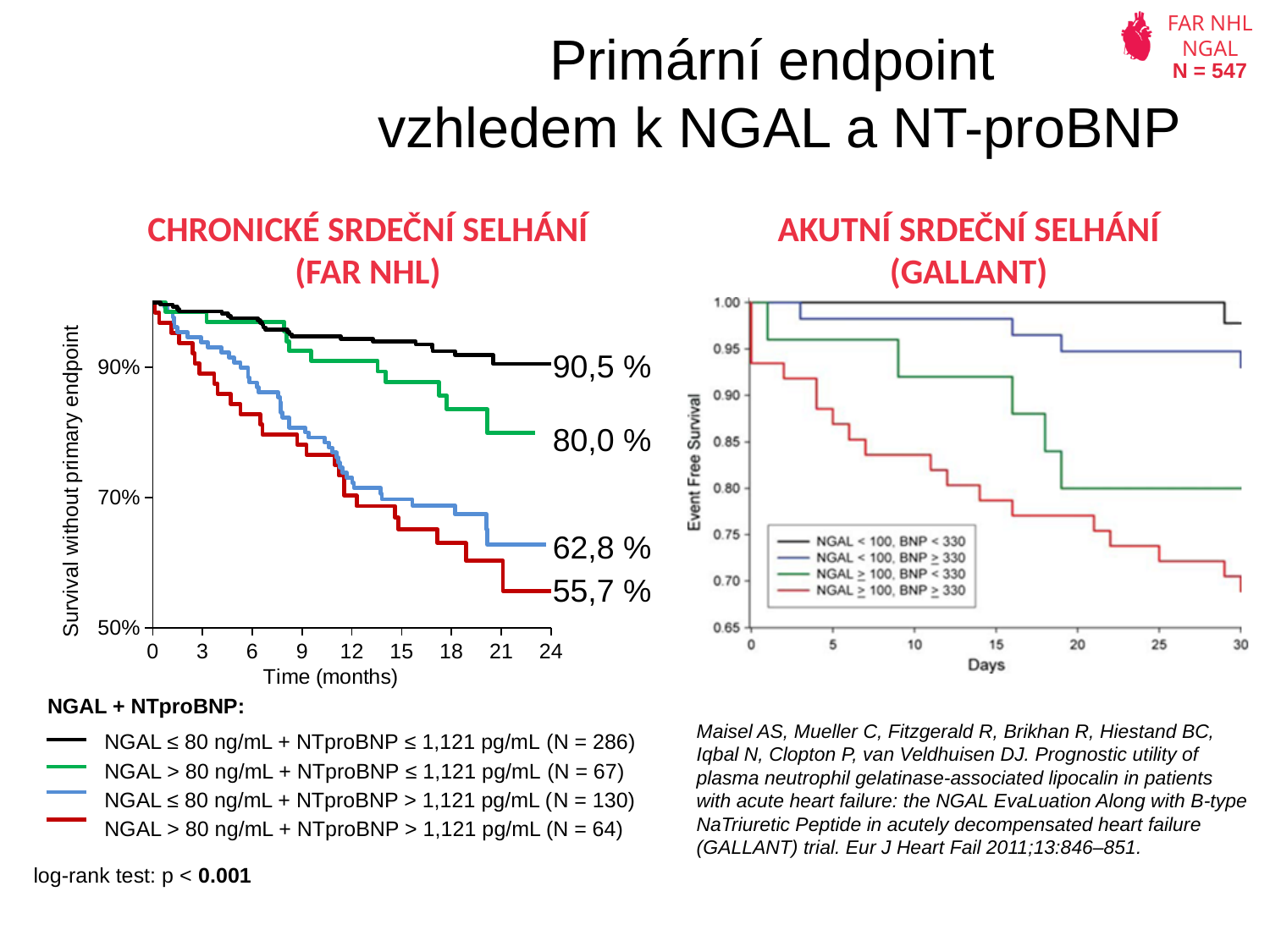
On the right chart (GALLANT), is the event-free survival of the NGAL < 100, BNP < 330 group at day 30 greater or less than 0.95? greater On the left chart (FAR NHL), do the survival curves rise or fall over time? fall What kind of chart is the left chart (FAR NHL)? line chart (Kaplan-Meier survival curves) On the right chart (GALLANT), which group has the lowest event-free survival at day 30? NGAL ≥ 100, BNP ≥ 330 On the left chart (FAR NHL), how many patients are in the group NGAL ≤ 80 ng/mL + NTproBNP > 1,121 pg/mL according to the legend? 130 On the right chart (AKUTNÍ SRDEČNÍ SELHÁNÍ, GALLANT), how many series does the legend list? 4 On the left chart (FAR NHL), what is the final survival value for the group NGAL > 80 ng/mL + NTproBNP > 1,121 pg/mL? 55,7 % On the left chart (FAR NHL), which group has the highest survival without primary endpoint at the end of follow-up? NGAL ≤ 80 ng/mL + NTproBNP ≤ 1,121 pg/mL On the left chart (CHRONICKÉ SRDEČNÍ SELHÁNÍ, FAR NHL), what is the survival without primary endpoint at the end of follow-up for the group NGAL ≤ 80 ng/mL + NTproBNP ≤ 1,121 pg/mL? 90,5 % On the left chart (FAR NHL), how many groups (series) does the legend list? 4 On the left chart (FAR NHL), what is the difference between the final survival values of the green group (80,0 %) and the blue group (62,8 %)? 17,2 % On the left chart (FAR NHL), which group has the lowest survival without primary endpoint at the end of follow-up? NGAL > 80 ng/mL + NTproBNP > 1,121 pg/mL